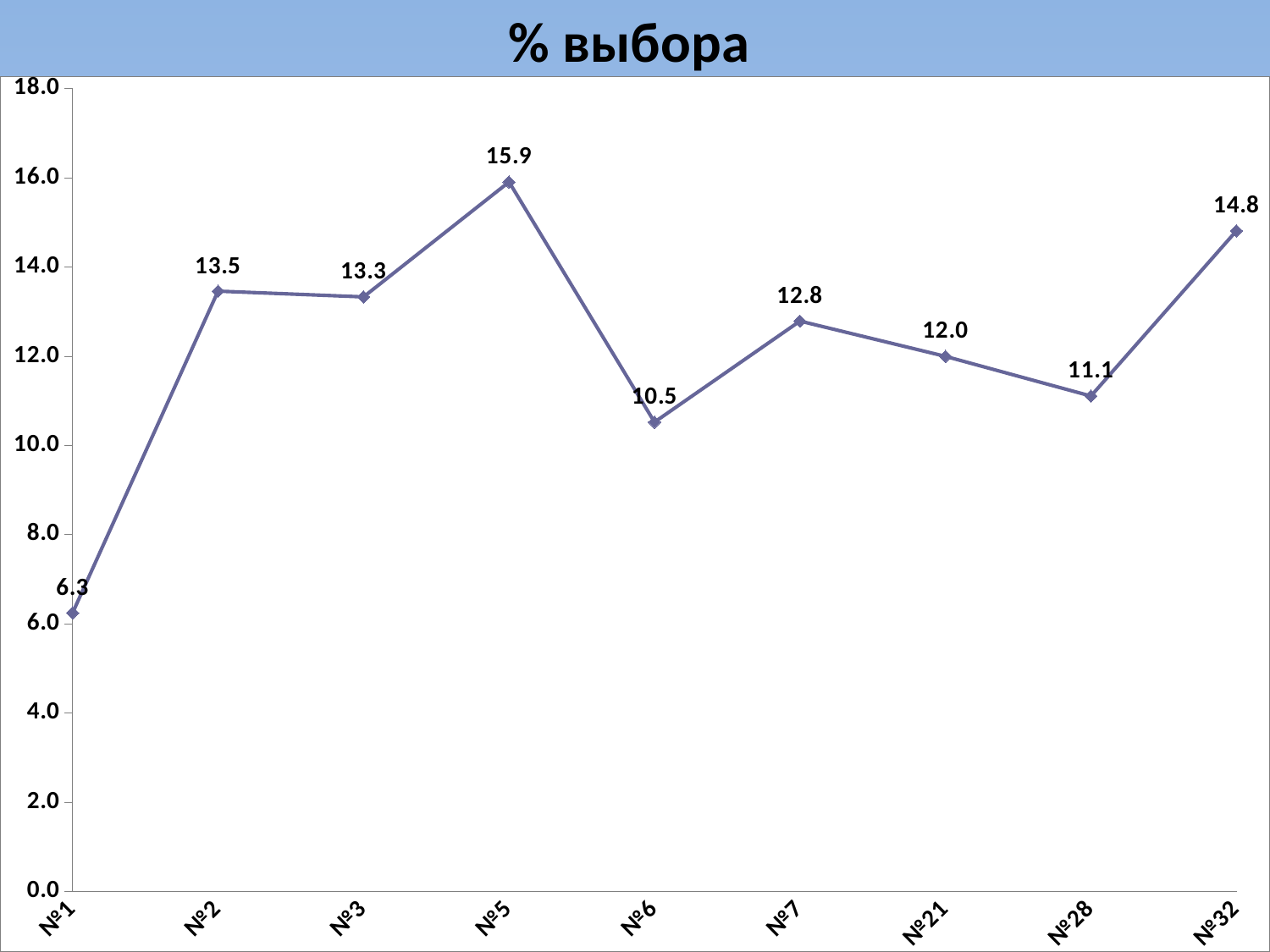
What is the value for №5? 15.9 What is the difference between the values for №32 and №1? 8.5 Which category has the lowest value? №1 What kind of chart is shown on the slide? line chart What is the value for №1? 6.3 What is the value for №28? 11.1 What is the title of the chart? % выбора Which is larger, the value for №7 or the value for №21? №7 Which category has the highest value? №5 What is the difference between the values for №5 and №6? 5.4 How many categories are plotted on the x axis? 9 Is the value for №2 greater or less than 12.0? greater